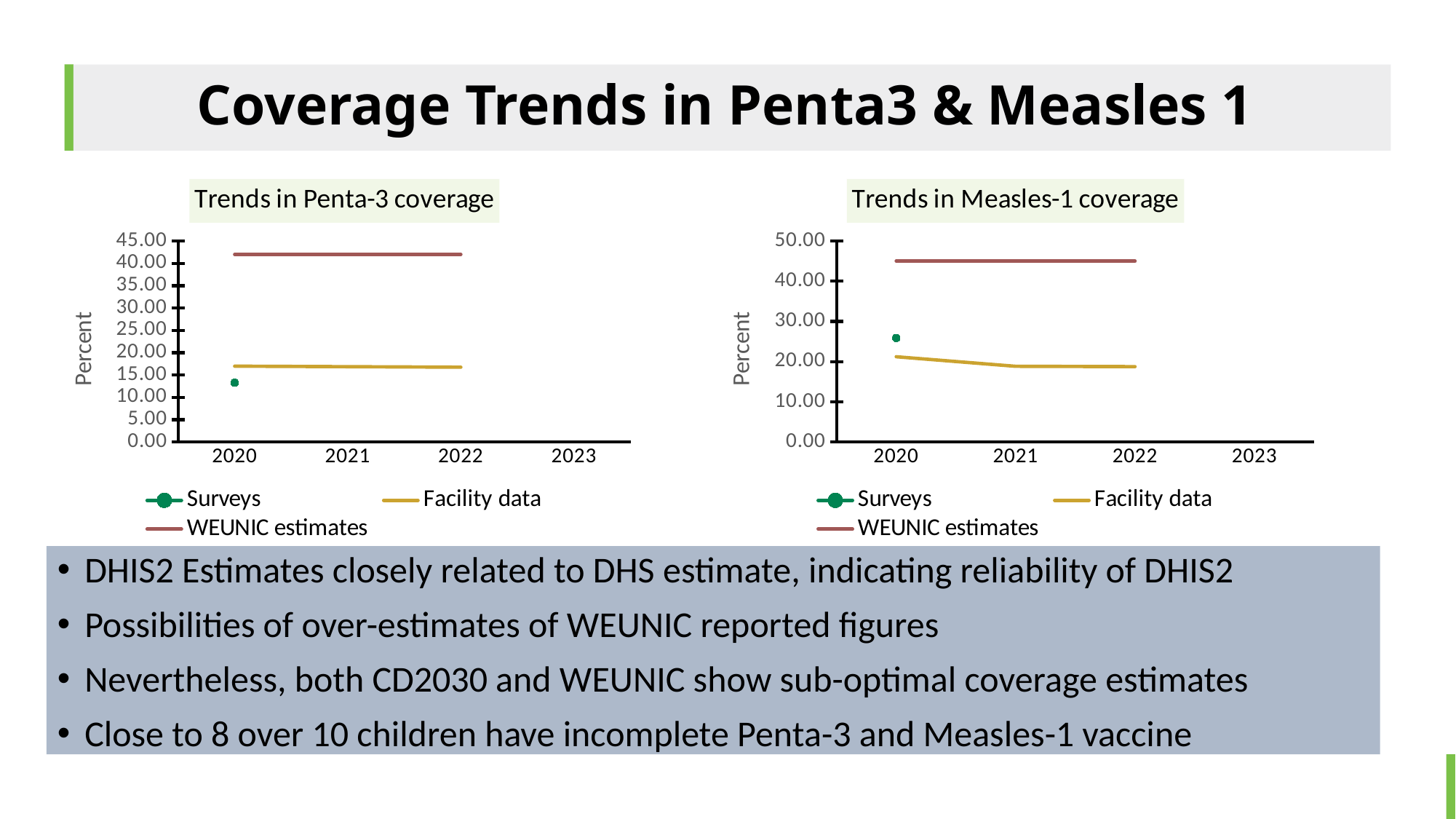
In the 'Trends in Measles-1 coverage' chart, is the WEUNIC estimates value for 2021 greater or less than 40? greater How many series does the legend of the 'Trends in Measles-1 coverage' chart list? 3 In the 'Trends in Measles-1 coverage' chart, does the Facility data series rise or fall from 2020 to 2022? fall In the 'Trends in Measles-1 coverage' chart, is the Surveys value for 2020 greater or less than 20? greater What is the y-axis label of the 'Trends in Measles-1 coverage' chart? Percent How many years are labelled on the x axis of the 'Trends in Penta-3 coverage' chart? 4 In the 'Trends in Penta-3 coverage' chart, is the WEUNIC estimates value for 2020 greater or less than 35? greater In the 'Trends in Measles-1 coverage' chart, which series has the larger value in 2020, Surveys or Facility data? Surveys What kind of chart is the 'Trends in Penta-3 coverage' chart? line chart In the 'Trends in Penta-3 coverage' chart, which series has the larger value in 2022, WEUNIC estimates or Facility data? WEUNIC estimates